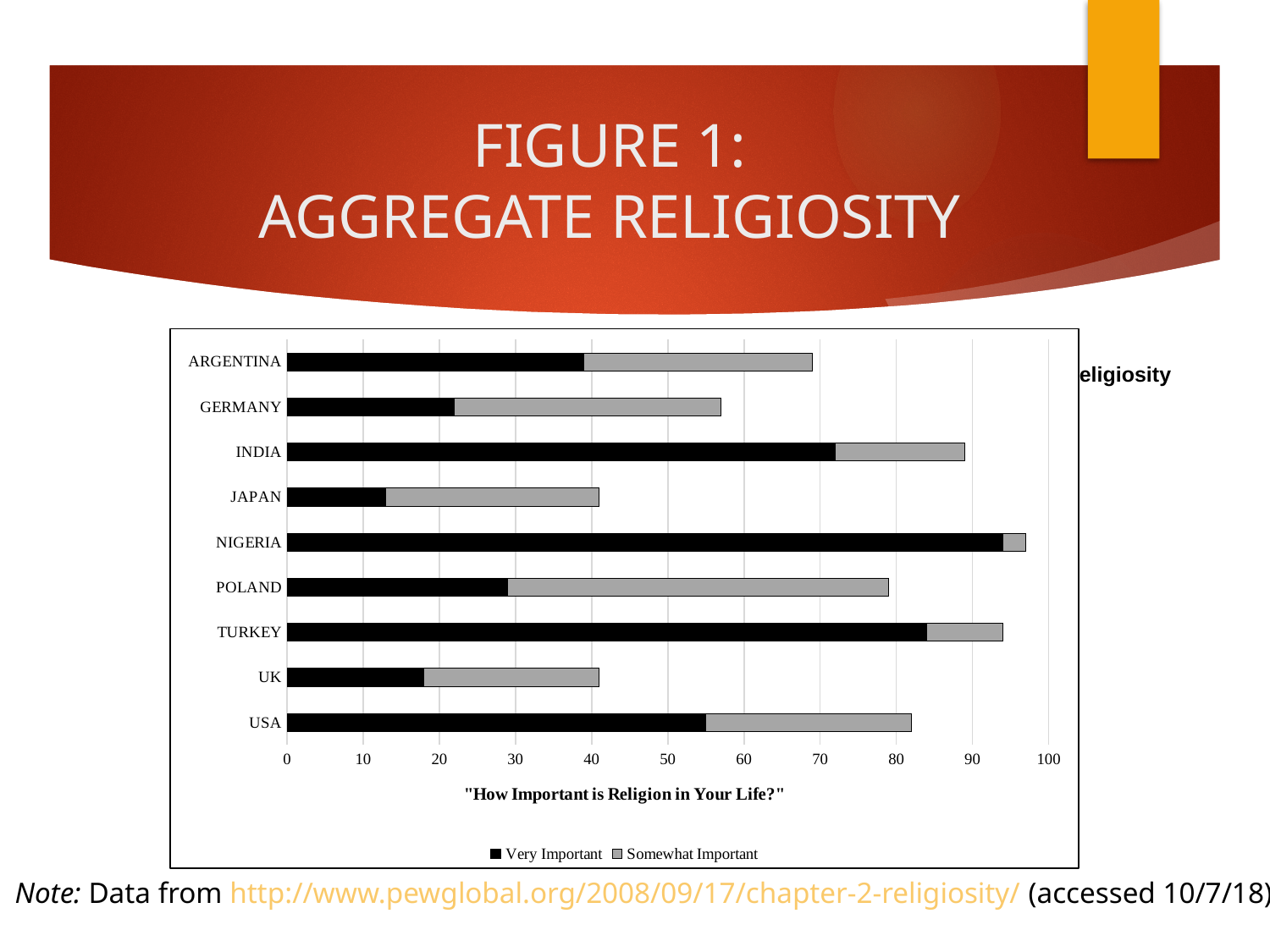
How many countries are listed on the chart? 9 Is the total bar length for Germany greater or less than 60? less What is the title printed below the x axis of the chart? "How Important is Religion in Your Life?" How many series does the chart legend list? 2 Is the "Very Important" value for USA greater or less than 50? greater Which has the larger "Very Important" value, India or USA? India Which has the larger "Very Important" value, Germany or Poland? Poland What kind of chart is shown on the slide? bar chart Is the "Very Important" value for Japan greater or less than 10? greater Which country has the longest "Very Important" bar? Nigeria